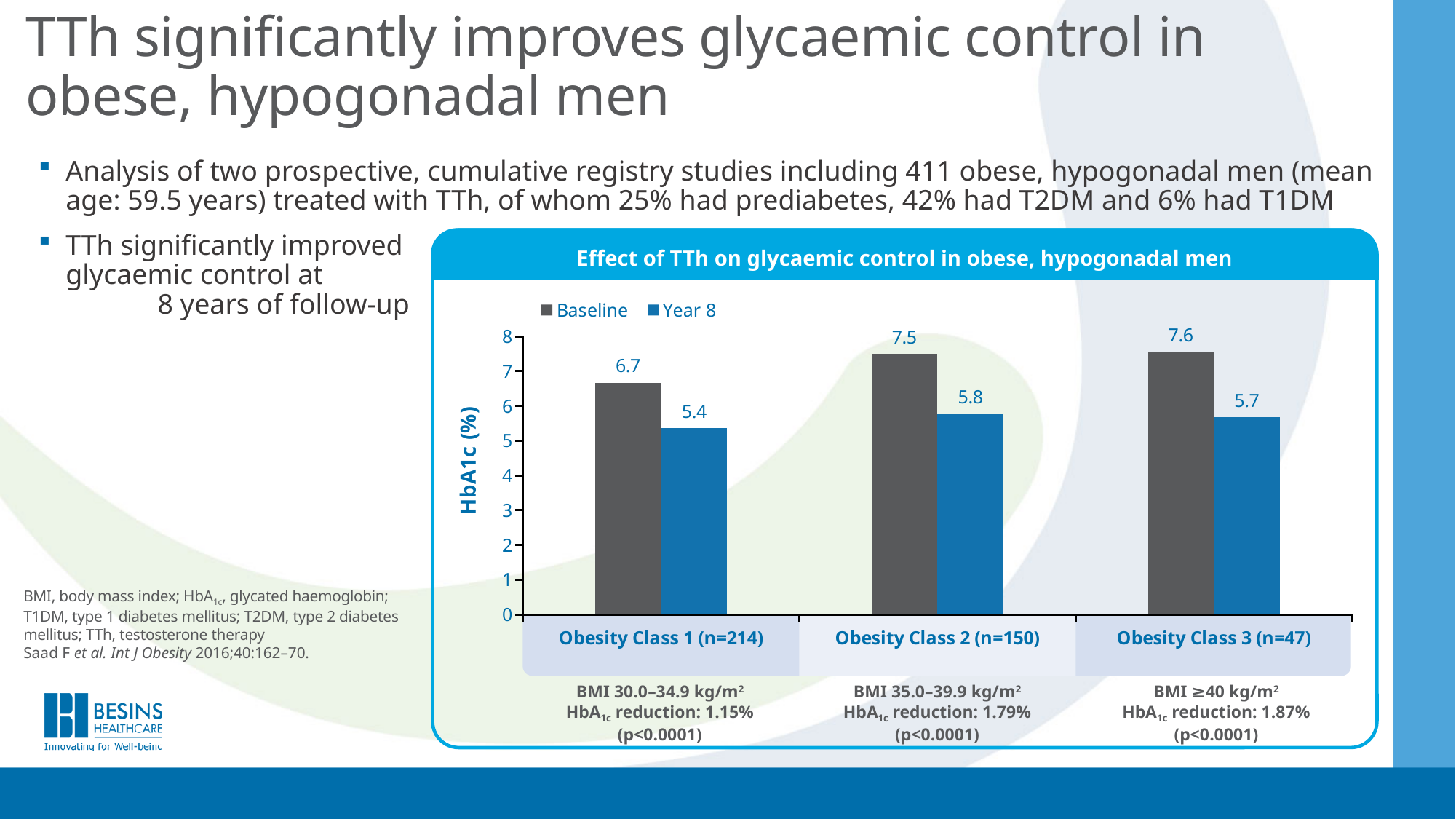
Which is larger for Obesity Class 3 (n=47): the Baseline value or the Year 8 value? Baseline What is the Baseline HbA1c value for Obesity Class 1 (n=214)? 6.7 What kind of chart is shown on the slide? bar chart Which obesity class has the highest Baseline HbA1c value? Obesity Class 3 (n=47) Which obesity class has the lowest Year 8 HbA1c value? Obesity Class 1 (n=214) What is the difference between the Baseline and Year 8 HbA1c values for Obesity Class 2 (n=150)? 1.7 What is the Year 8 HbA1c value for Obesity Class 3 (n=47)? 5.7 What is the Year 8 HbA1c value for Obesity Class 2 (n=150)? 5.8 What is the title of the chart? Effect of TTh on glycaemic control in obese, hypogonadal men Is the Year 8 HbA1c value for Obesity Class 1 (n=214) greater or less than 6? less How many series does the legend list? 2 How many obesity class categories are shown on the x axis? 3